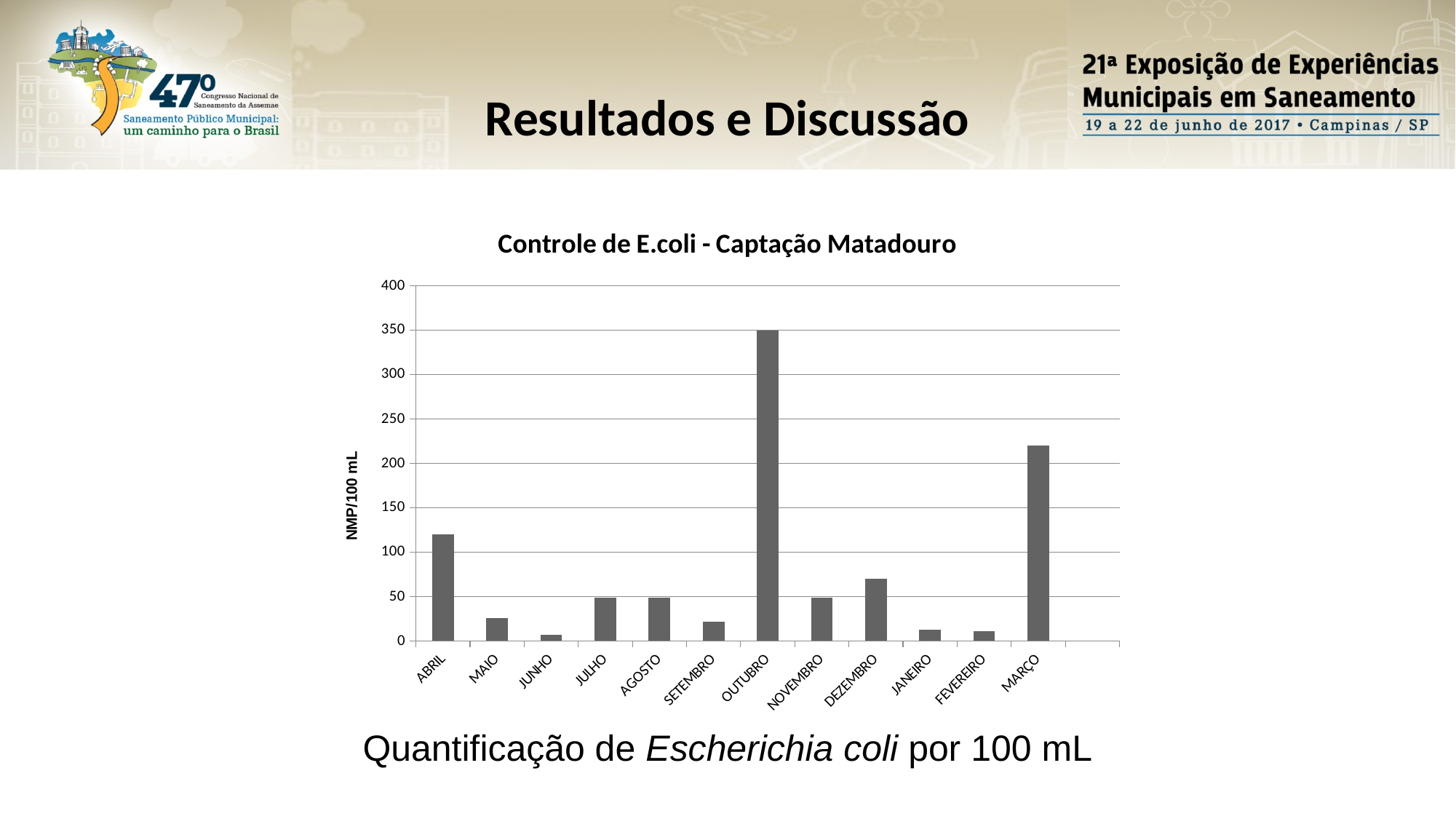
Is the value for MARÇO greater or less than 200? greater Is the value for ABRIL greater or less than 100? greater Which month has the highest value in the chart? OUTUBRO Is the value for MAIO greater or less than 50? less What is the label of the vertical axis? NMP/100 mL What kind of chart is shown on the slide? bar chart How many months are shown on the x axis of the chart? 12 Which is larger, the value for ABRIL or the value for MARÇO? MARÇO What is the title of the chart? Controle de E.coli - Captação Matadouro What is the value for OUTUBRO? 350